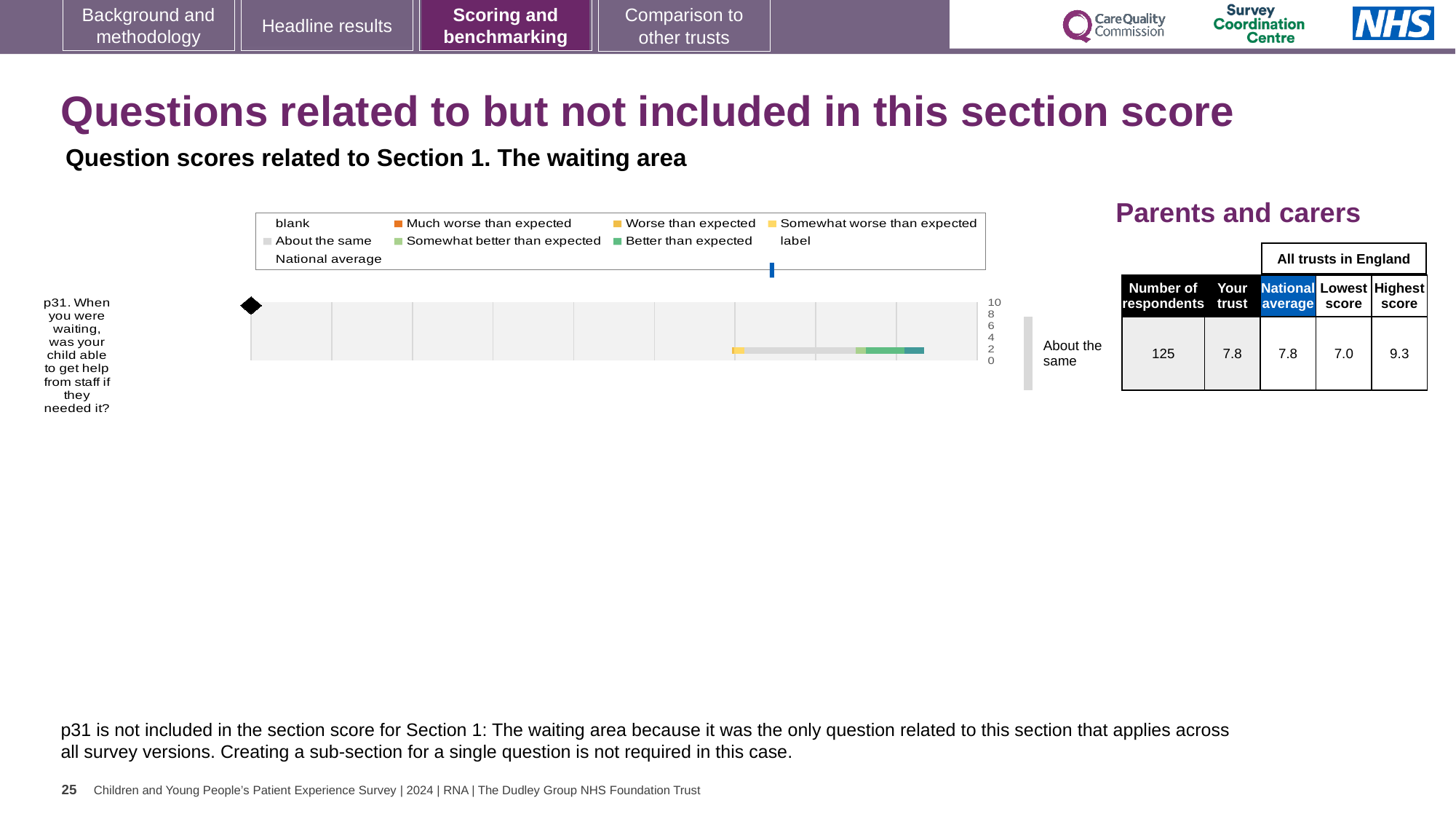
What does the label to the right of the p31 bar say about the trust's result? About the same In the Parents and carers table, what is the highest score across all trusts in England for p31? 9.3 In the Parents and carers table, what is the lowest score across all trusts in England for p31? 7.0 In the Parents and carers table, what is the 'Your trust' score for p31? 7.8 What kind of chart is used to show the result for question p31? bar chart Is the 'Your trust' score for p31 higher than, lower than, or equal to the national average? equal In the Parents and carers table, what is the national average score for p31? 7.8 What is the difference between the highest score and the lowest score for p31 in the table? 2.3 What is the difference between the highest score and the 'Your trust' score for p31? 1.5 Which legend entry is shown in orange in the chart legend? Much worse than expected How many respondents answered question p31 according to the table? 125 How many survey questions are plotted in the chart? 1